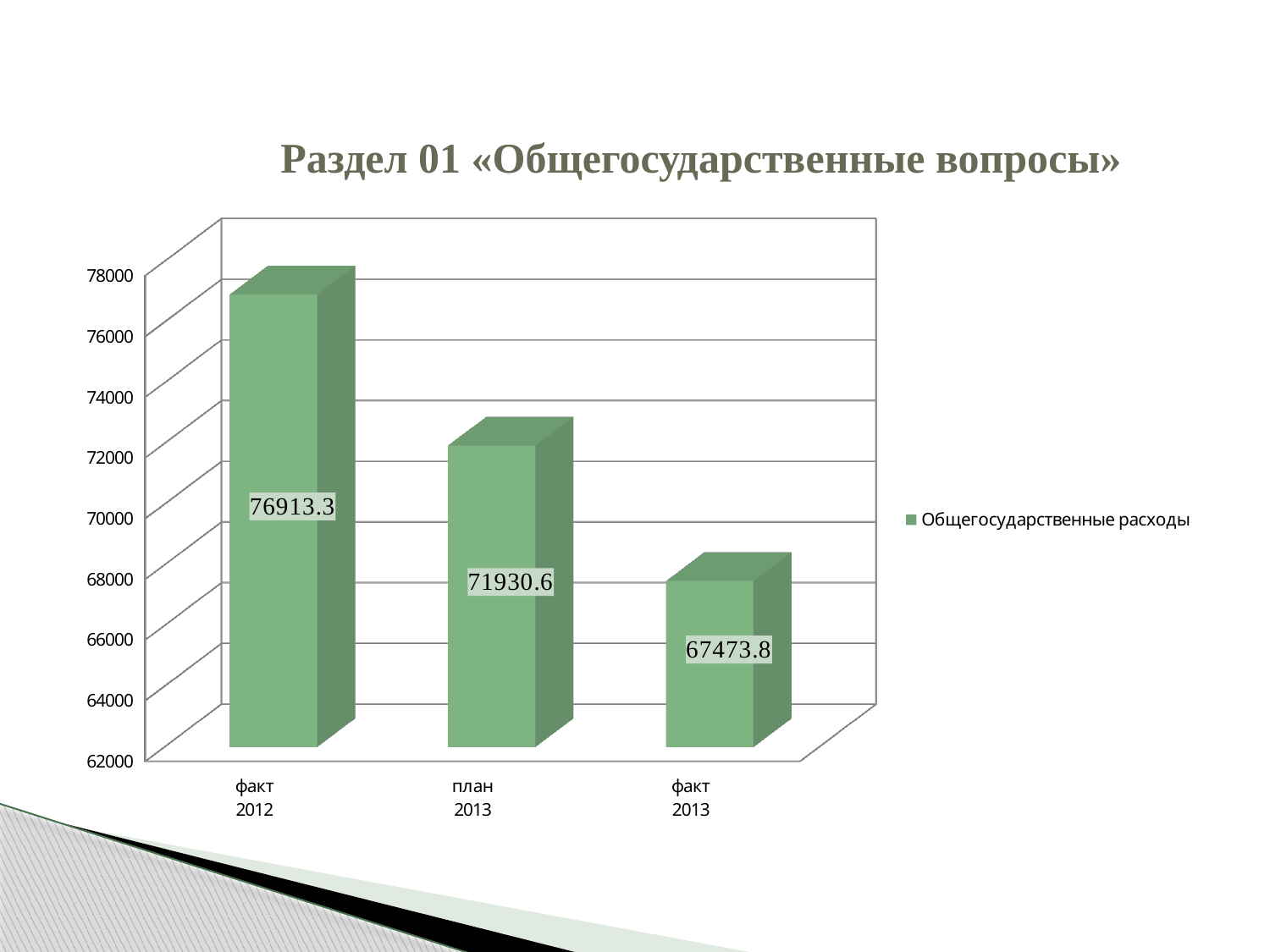
Which category has the highest value? факт 2012 Which is larger, the value for план 2013 or the value for факт 2013? план 2013 How many categories are shown on the x axis? 3 What is the value for факт 2013? 67473.8 What is the value for план 2013? 71930.6 Is the value for план 2013 greater or less than 70000? greater What is the difference between the values for факт 2012 and факт 2013? 9439.5 What kind of chart is shown on the slide? bar chart What is the value for факт 2012? 76913.3 What series name does the legend list? Общегосударственные расходы What is the difference between the values for план 2013 and факт 2013? 4456.8 Which category has the lowest value? факт 2013